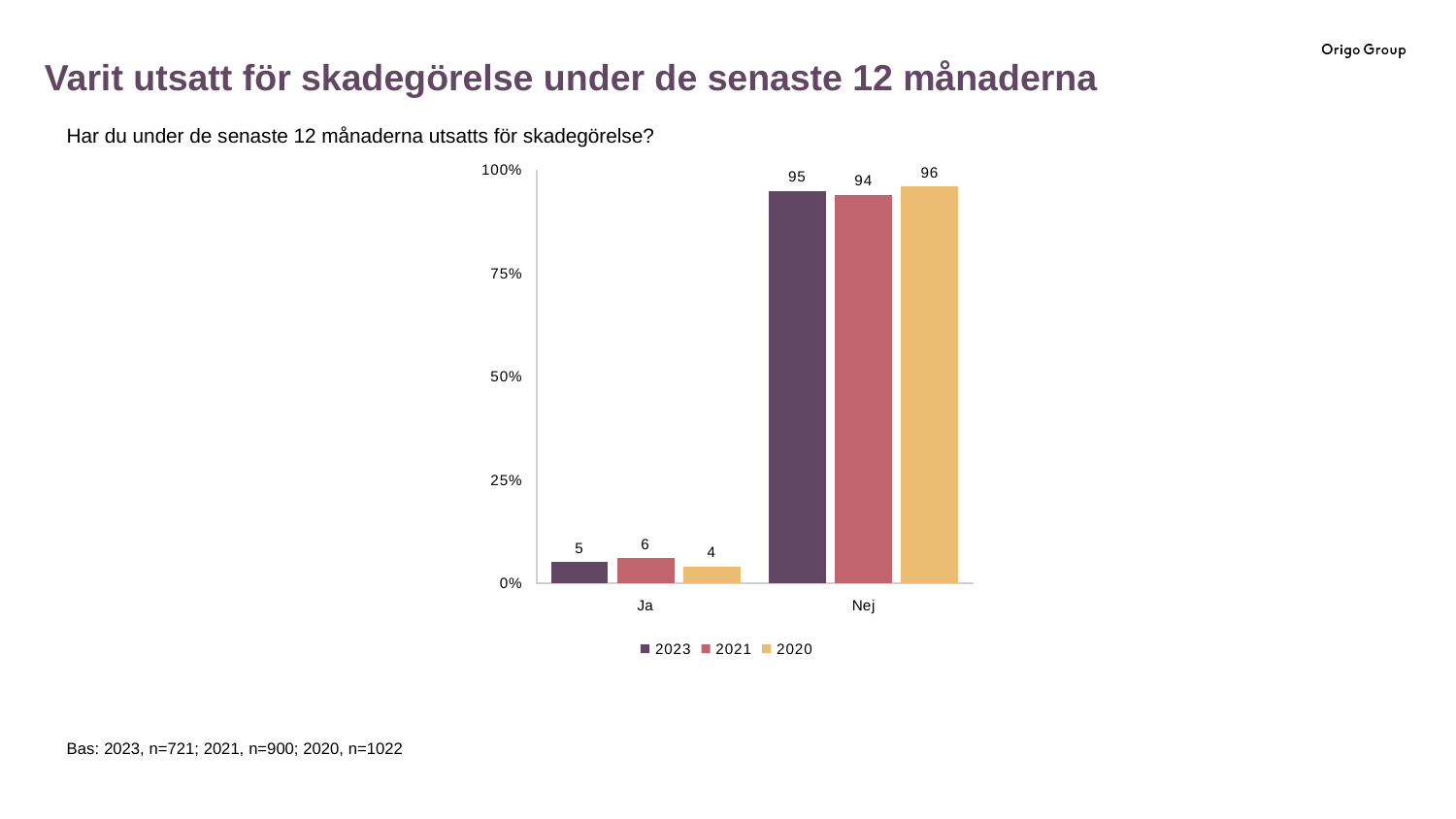
Which series has the highest value in the Nej category? 2020 Which is larger: the 2021 value for Ja or the 2023 value for Ja? 2021 value for Ja Which series has the lowest value in the Ja category? 2020 How many categories are shown on the x axis? 2 What is the question text shown above the chart? Har du under de senaste 12 månaderna utsatts för skadegörelse? What is the value for 2023 in the Ja category? 5 What is the difference between the 2023 values for Nej and Ja? 90 What is the value for 2021 in the Nej category? 94 What is the value for 2020 in the Ja category? 4 What kind of chart is shown on the slide? Bar chart What is the value for 2020 in the Nej category? 96 How many series does the legend list? 3